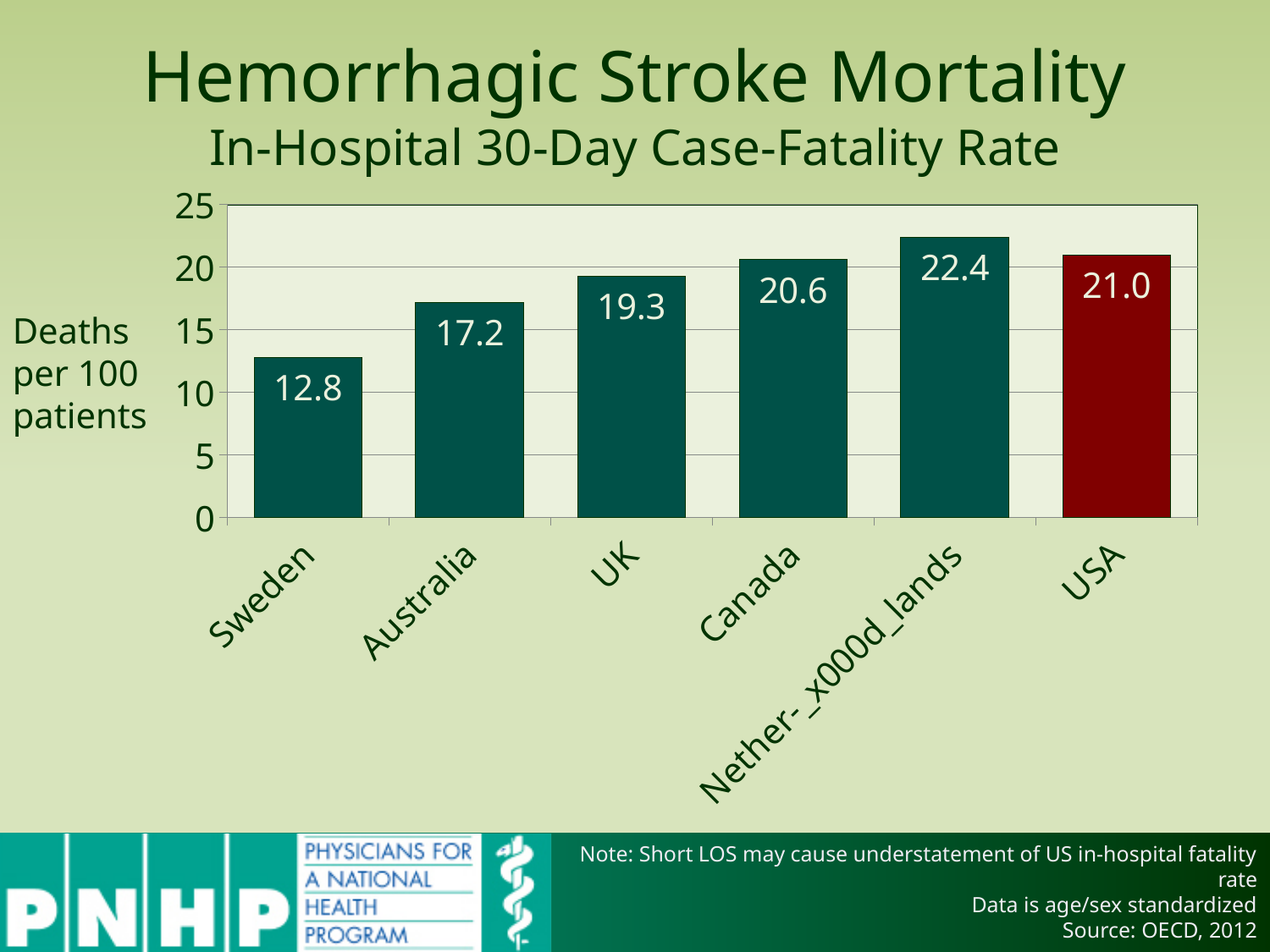
What is the value shown for Canada? 20.6 Which has a higher case-fatality rate, the UK or Canada? Canada Which country has the highest in-hospital 30-day case-fatality rate? Netherlands Which country has the lowest in-hospital 30-day case-fatality rate? Sweden Which bar is shown in a different colour (dark red) from the others? USA Is the value for Australia greater or less than 15? greater What is the hemorrhagic stroke case-fatality rate for Sweden? 12.8 What is the difference between the values for the Netherlands and the USA? 1.4 What kind of chart is shown on the slide? Bar chart How many countries are shown in the chart? 6 What is the difference between the values for the UK and Australia? 2.1 What is the value shown for the USA? 21.0